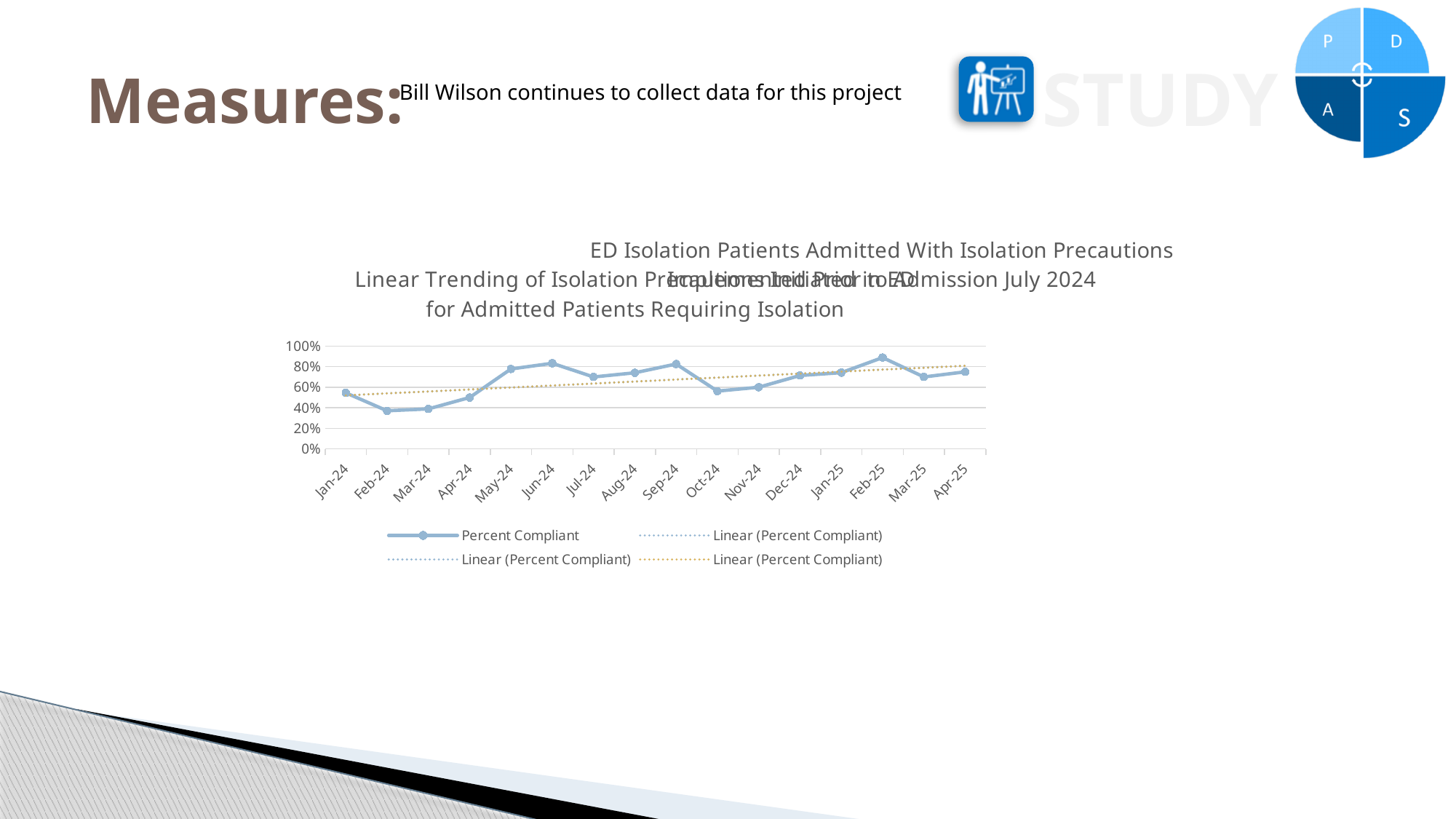
Which month has the highest Percent Compliant value? Feb-25 Which month has the larger Percent Compliant value, Apr-24 or May-24? May-24 What kind of chart is shown on the slide? Line chart Does the dotted linear trend line rise or fall from Jan-24 to Apr-25? Rises Is the Percent Compliant value for Feb-24 greater or less than 60%? less Is the Percent Compliant value for Feb-25 greater or less than 80%? greater Which month has the larger Percent Compliant value, Feb-25 or Mar-25? Feb-25 How many entries does the chart's legend list? 4 What is the name of the solid line series in the legend? Percent Compliant How many months are plotted along the x axis of the chart? 16 Is the Percent Compliant value for Apr-24 greater or less than 60%? less